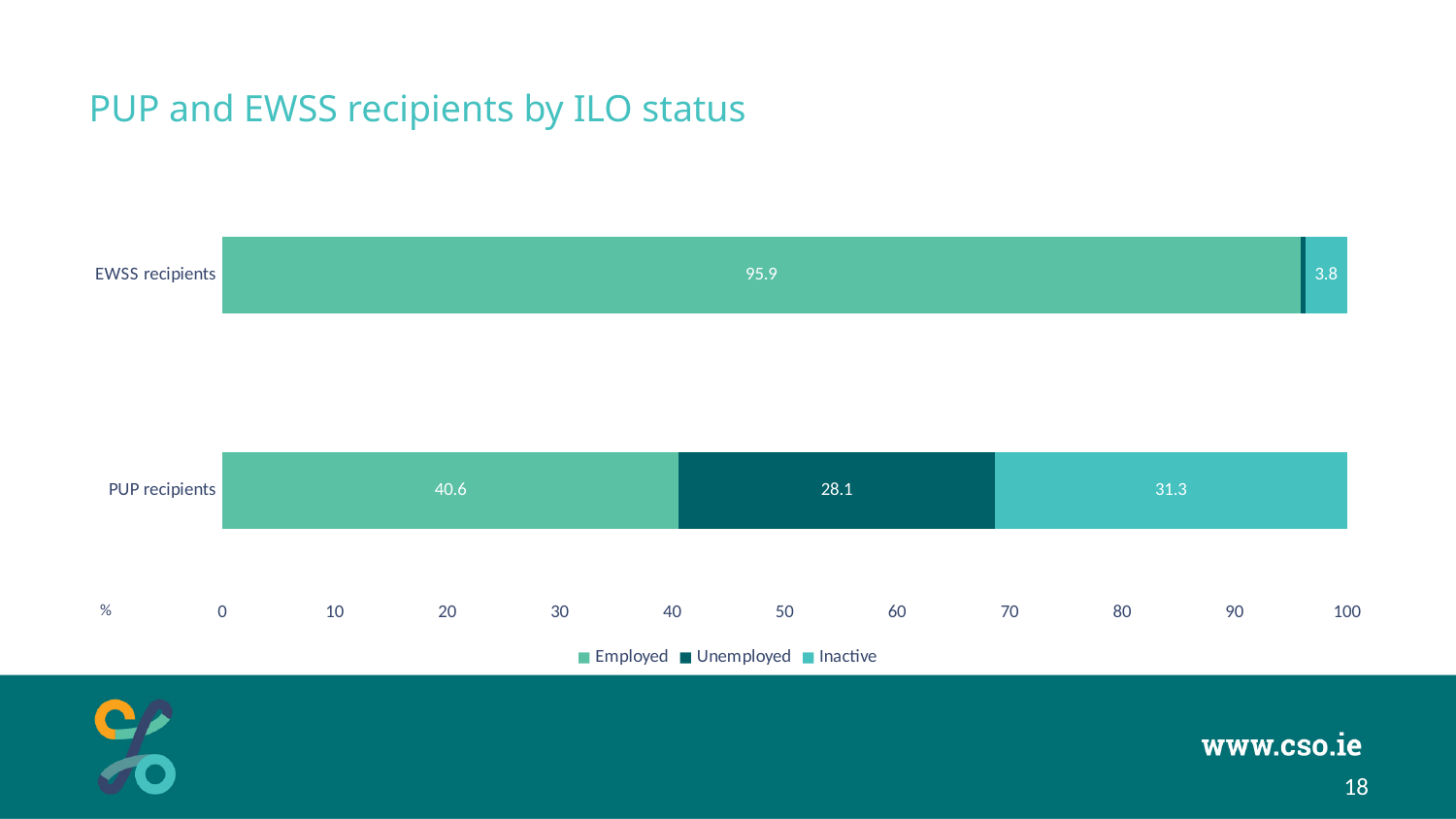
Which ILO status has the largest share among PUP recipients? Employed What kind of chart is shown on the slide? Stacked bar chart What is the Unemployed value for PUP recipients? 28.1 What is the difference between the Employed values for EWSS recipients and PUP recipients? 55.3 How many series does the legend list? 3 How many categories (bars) are shown on the chart? 2 What is the Inactive value for EWSS recipients? 3.8 Which is larger for PUP recipients, the Inactive value or the Unemployed value? Inactive What is the Inactive value for PUP recipients? 31.3 What is the title of the chart? PUP and EWSS recipients by ILO status What is the Employed value for EWSS recipients? 95.9 What is the Employed value for PUP recipients? 40.6